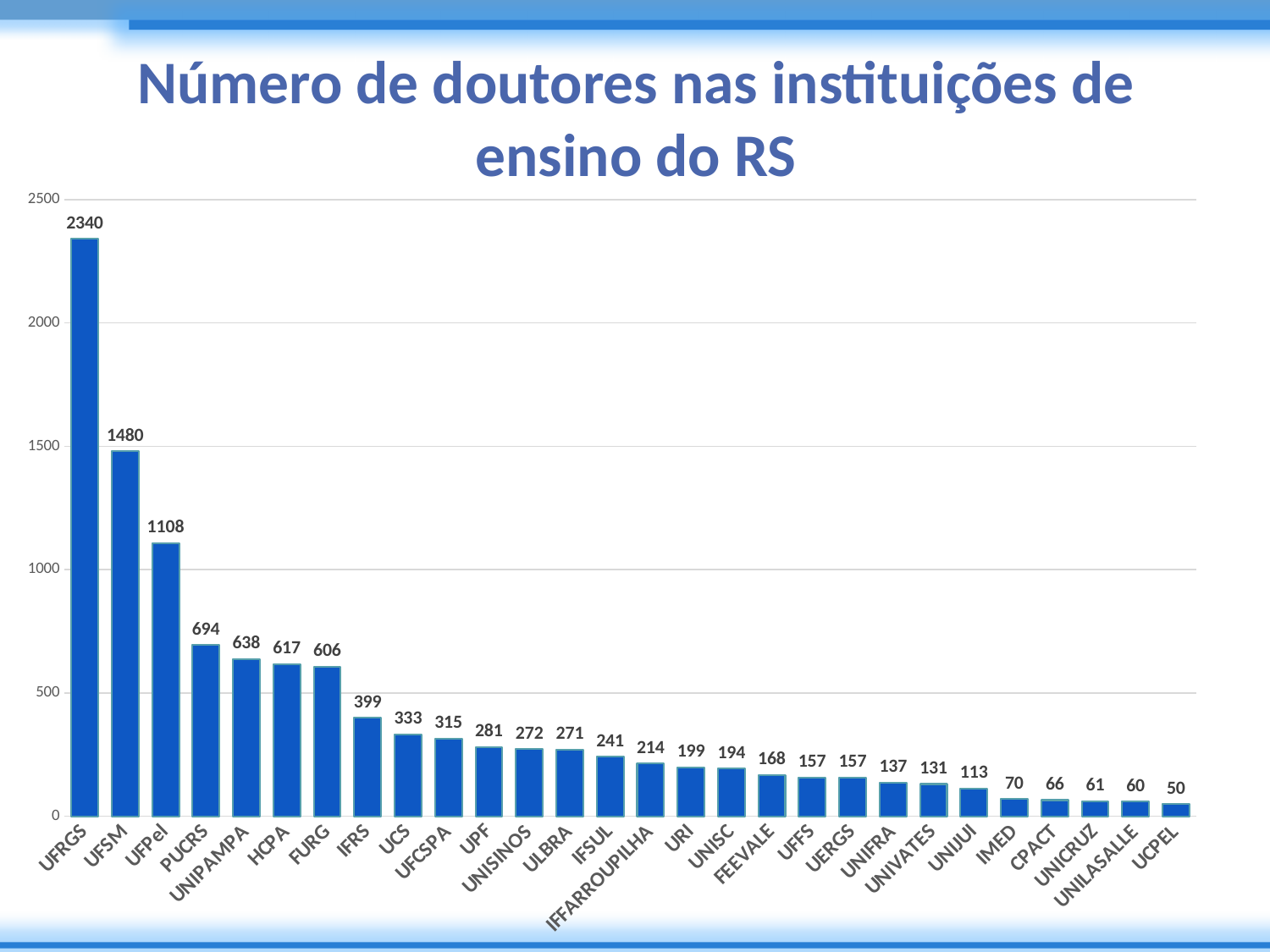
What is the value for UNISINOS? 272 How many institutions are shown on the chart? 28 Is the value for UFPel greater or less than 1000? greater Which institution has the lowest number of doutores? UCPEL Which institution has the highest number of doutores? UFRGS Which is larger, the value for HCPA or the value for FURG? HCPA What is the value for UNIVATES? 131 What is the difference between the values for IFRS and UCS? 66 What is the value for UFRGS? 2340 What type of chart is shown on the slide? Bar chart What is the value for PUCRS? 694 What is the difference between the values for UFRGS and UFSM? 860